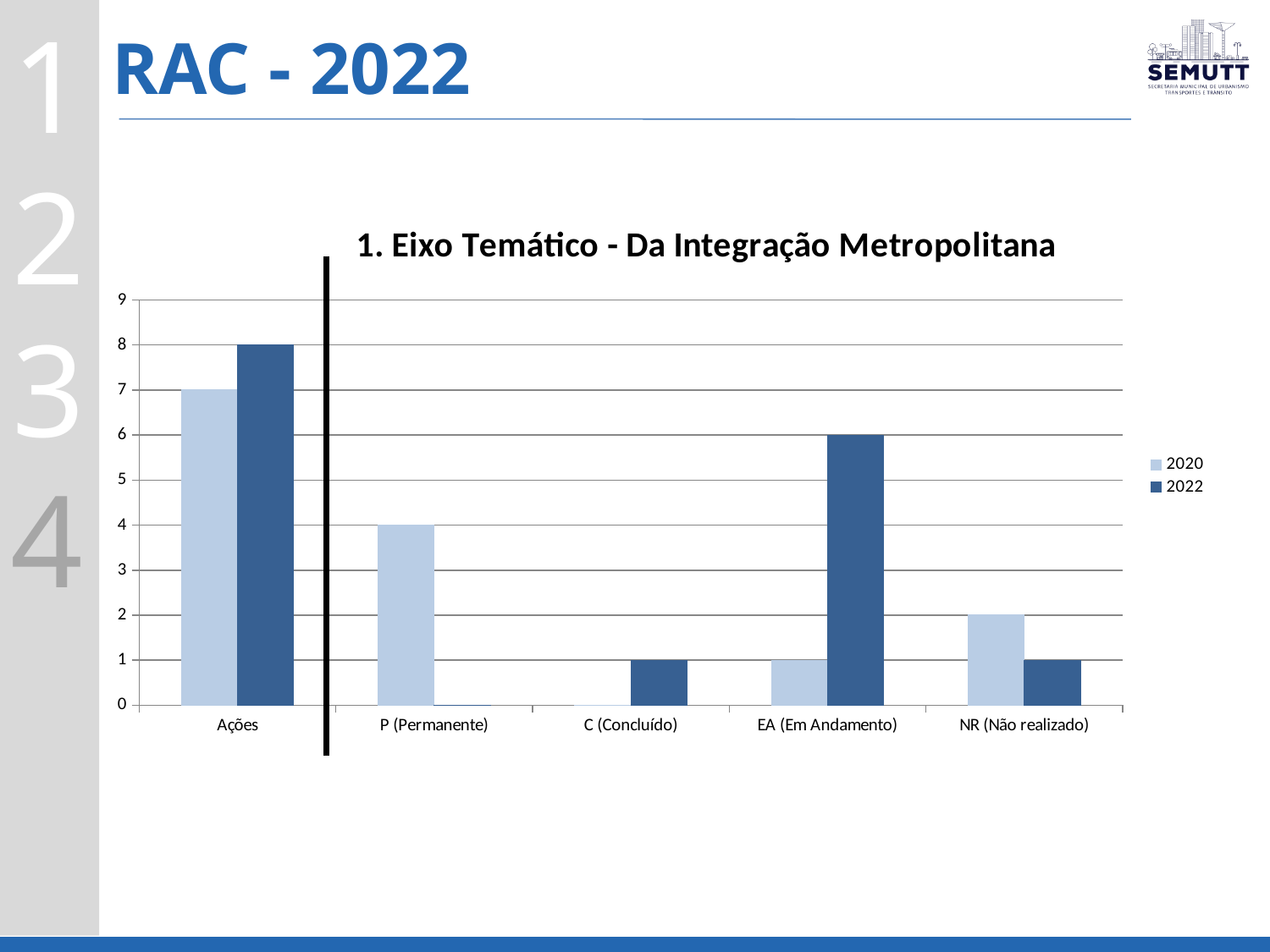
What is the value for EA (Em Andamento) in the 2022 series? 6 What is the value for P (Permanente) in the 2020 series? 4 Which is larger for NR (Não realizado): the 2020 value or the 2022 value? 2020 Which category has the highest value in the 2022 series? Ações What is the title of the chart? 1. Eixo Temático - Da Integração Metropolitana What kind of chart is shown on the slide? bar chart What is the value for NR (Não realizado) in the 2020 series? 2 What is the difference between the 2022 and 2020 values for EA (Em Andamento)? 5 How many categories are shown on the x axis? 5 What is the value for Ações in the 2020 series? 7 How many series does the legend list? 2 What is the value for Ações in the 2022 series? 8